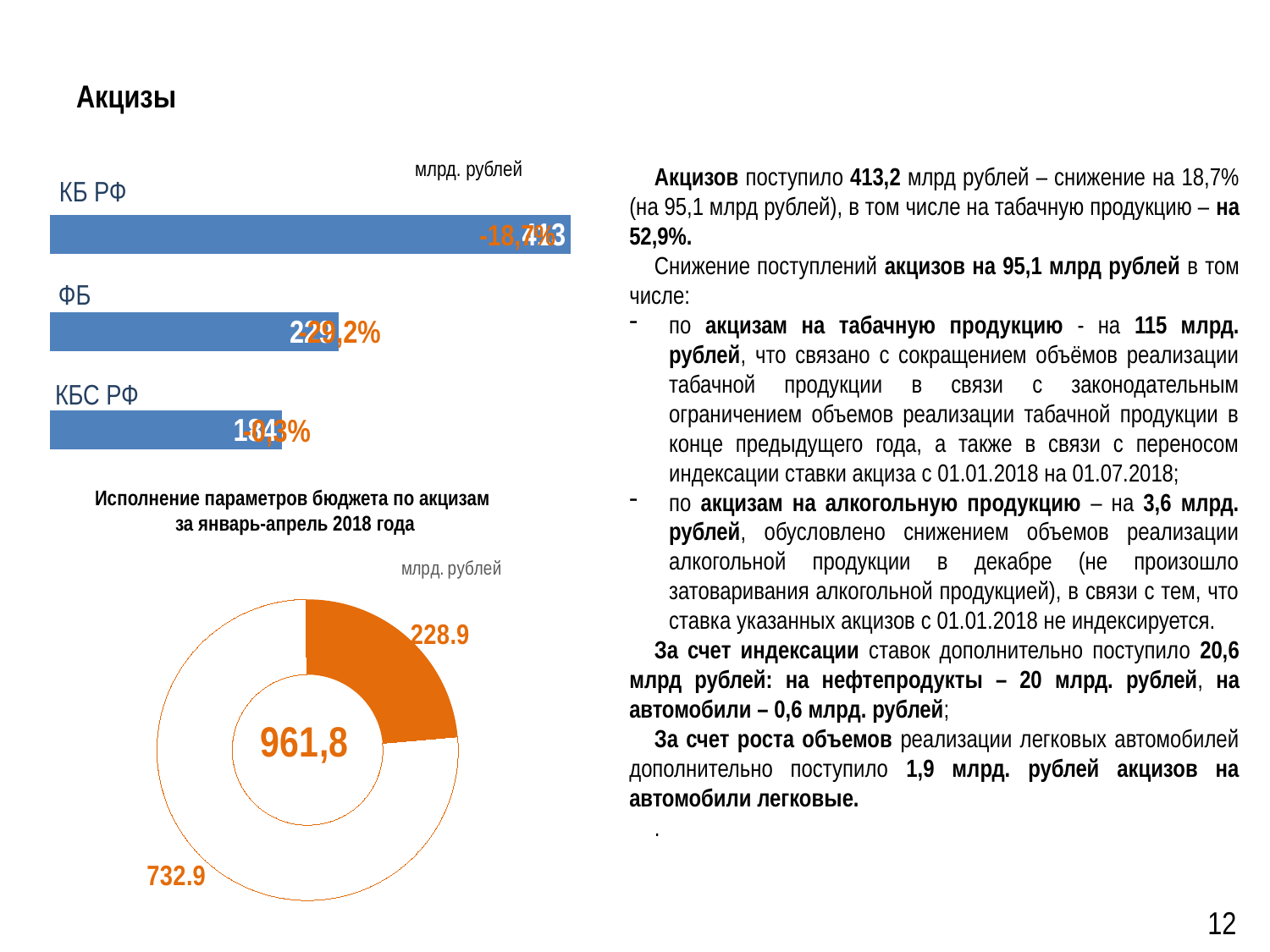
In the doughnut chart 'Исполнение параметров бюджета по акцизам за январь-апрель 2018 года', what is the difference between the two segment values, 732.9 and 228.9? 504.0 What kind of chart is shown at the top left of the slide (КБ РФ, ФБ, КБС РФ)? bar chart In the doughnut chart 'Исполнение параметров бюджета по акцизам за январь-апрель 2018 года', what value is shown for the white segment? 732.9 In the bar chart at the top left, which category has the longest bar? КБ РФ How many categories does the bar chart at the top left of the slide show? 3 In the bar chart at the top left, which category has the shortest bar? КБС РФ In the doughnut chart 'Исполнение параметров бюджета по акцизам за январь-апрель 2018 года', what value is shown for the orange segment? 228.9 In the bar chart at the top left, which bar is longer: ФБ or КБС РФ? ФБ What unit is stated above the bar chart at the top left of the slide? млрд. рублей What number is printed in the centre of the doughnut chart 'Исполнение параметров бюджета по акцизам за январь-апрель 2018 года'? 961,8 In the doughnut chart 'Исполнение параметров бюджета по акцизам за январь-апрель 2018 года', which segment is larger: the orange one or the white one? the white one What kind of chart is 'Исполнение параметров бюджета по акцизам за январь-апрель 2018 года'? doughnut chart